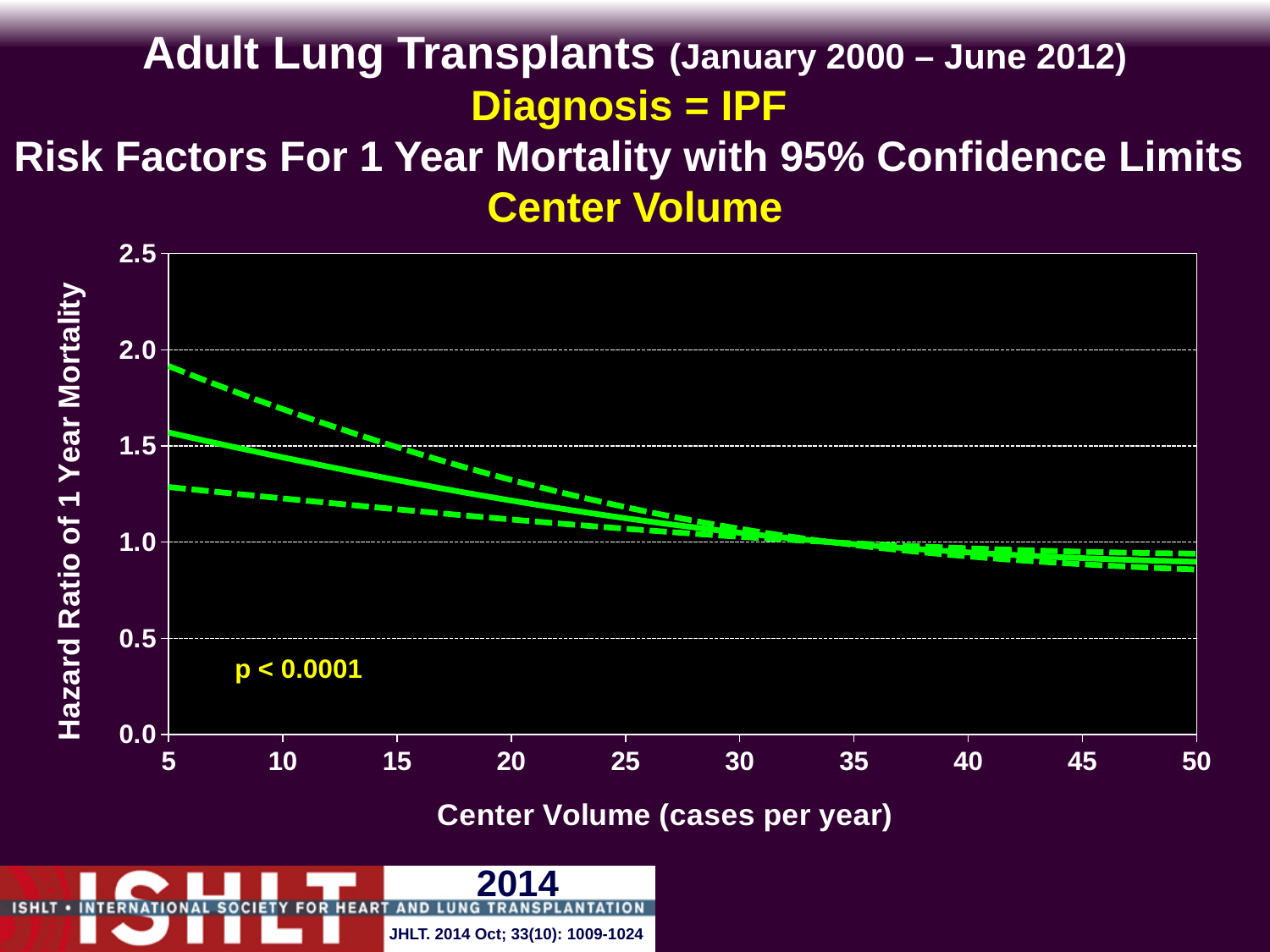
Is the lower confidence limit (lower dashed line) at a center volume of 5 greater or less than 1.0? greater What p-value is printed on the chart? p < 0.0001 Is the hazard ratio on the solid line at a center volume of 50 greater or less than 1.0? less At which center volume shown on the x axis is the hazard ratio on the solid line highest? 5 What is the label of the x axis? Center Volume (cases per year) Is the upper confidence limit (upper dashed line) at a center volume of 5 greater or less than 2.0? less What kind of chart is shown on the slide? line chart Is the hazard ratio on the solid line higher at a center volume of 10 or at a center volume of 40? 10 Does the hazard ratio of 1 year mortality rise or fall as center volume increases? fall How many lines are plotted on the chart? 3